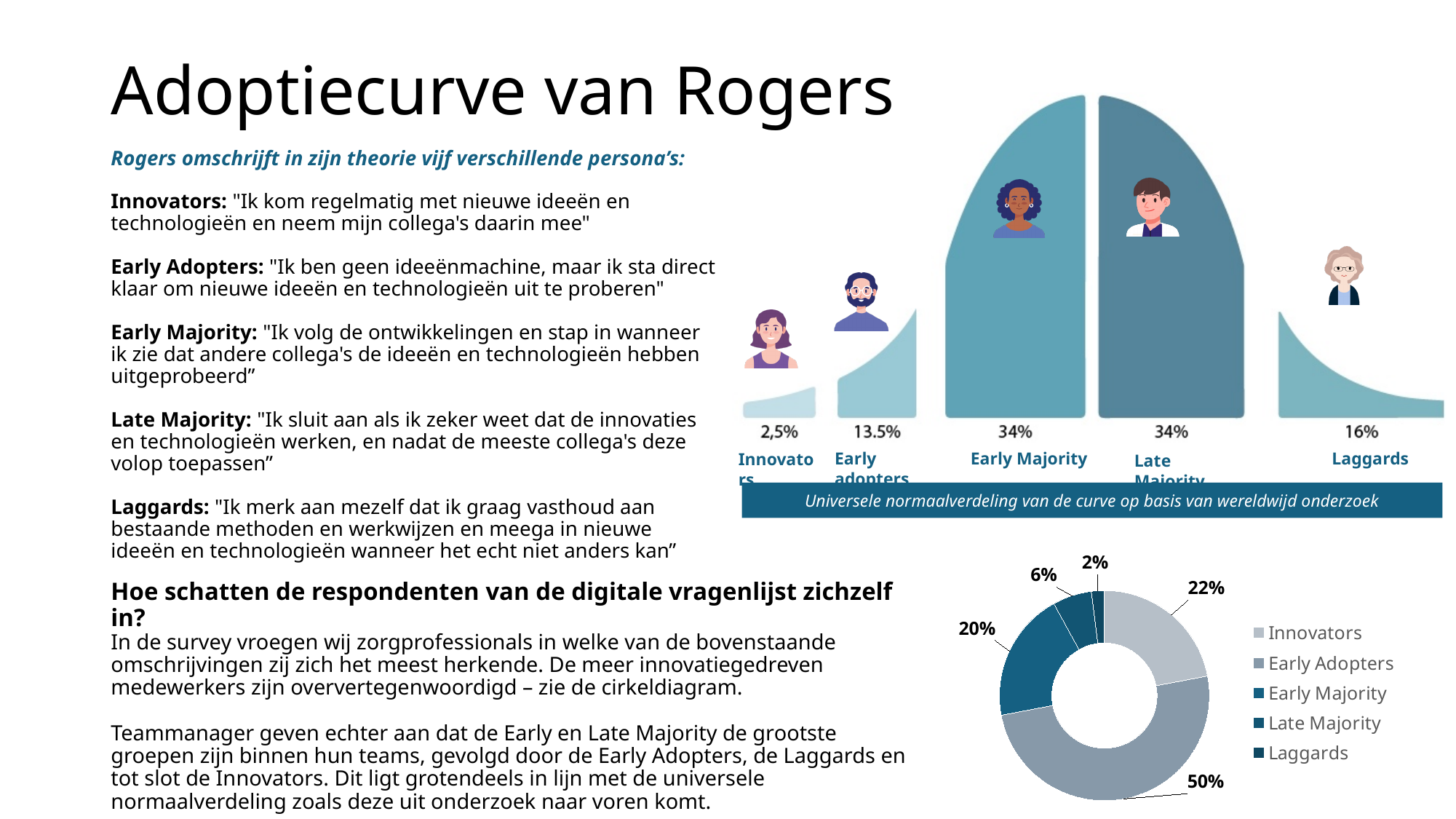
In the pie chart, what share of respondents identified as Late Majority? 6% How many categories does the legend of the pie chart list? 5 In the adoption curve illustration at the top right, what percentage is shown for Laggards? 16% In the pie chart, which category has the smallest share? Laggards In the pie chart, what share of respondents identified as Laggards? 2% In the pie chart, what share of respondents identified as Early Adopters? 50% In the pie chart, what share of respondents identified as Early Majority? 20% In the pie chart, what share of respondents identified as Innovators? 22% In the pie chart, which category has the largest share? Early Adopters What kind of chart is the chart at the bottom right of the slide? Pie chart (donut) In the pie chart, what is the difference between the Early Adopters share and the Innovators share? 28% In the pie chart, which is larger: the share for Innovators or the share for Early Majority? Innovators